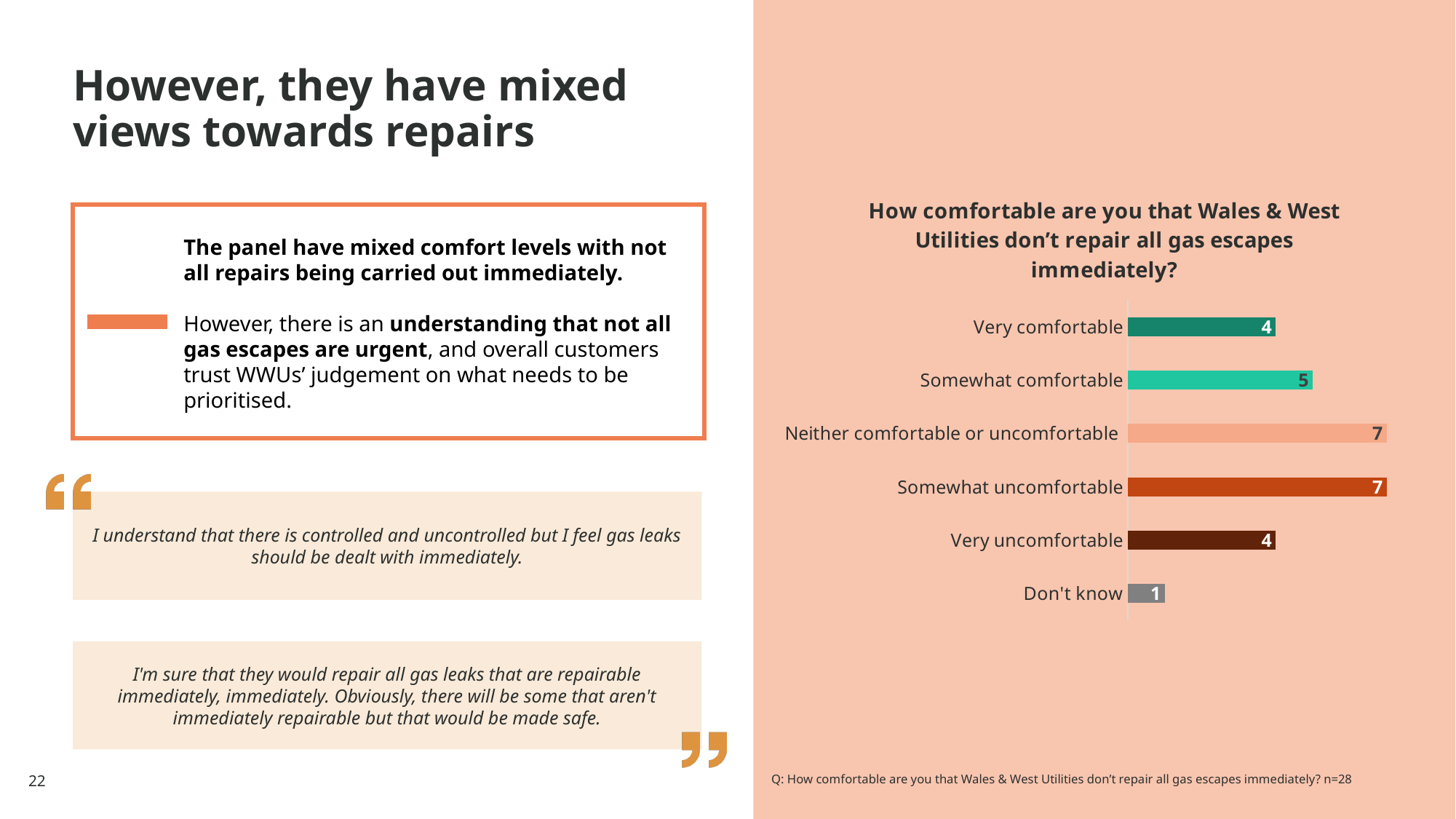
What is the value for Somewhat comfortable? 5 What kind of chart is shown on the slide? Bar chart Which category has the lowest value? Don't know What is the value for Don't know? 1 How many categories are shown in the chart? 6 Which is larger, the value for Somewhat comfortable or the value for Very comfortable? Somewhat comfortable What is the total of all the values shown in the chart? 28 What is the difference between the values for Somewhat uncomfortable and Very uncomfortable? 3 What is the value for Neither comfortable or uncomfortable? 7 What is the value for Very comfortable? 4 What is the sample size (n) stated below the chart? n=28 What is the title of the chart? How comfortable are you that Wales & West Utilities don't repair all gas escapes immediately?